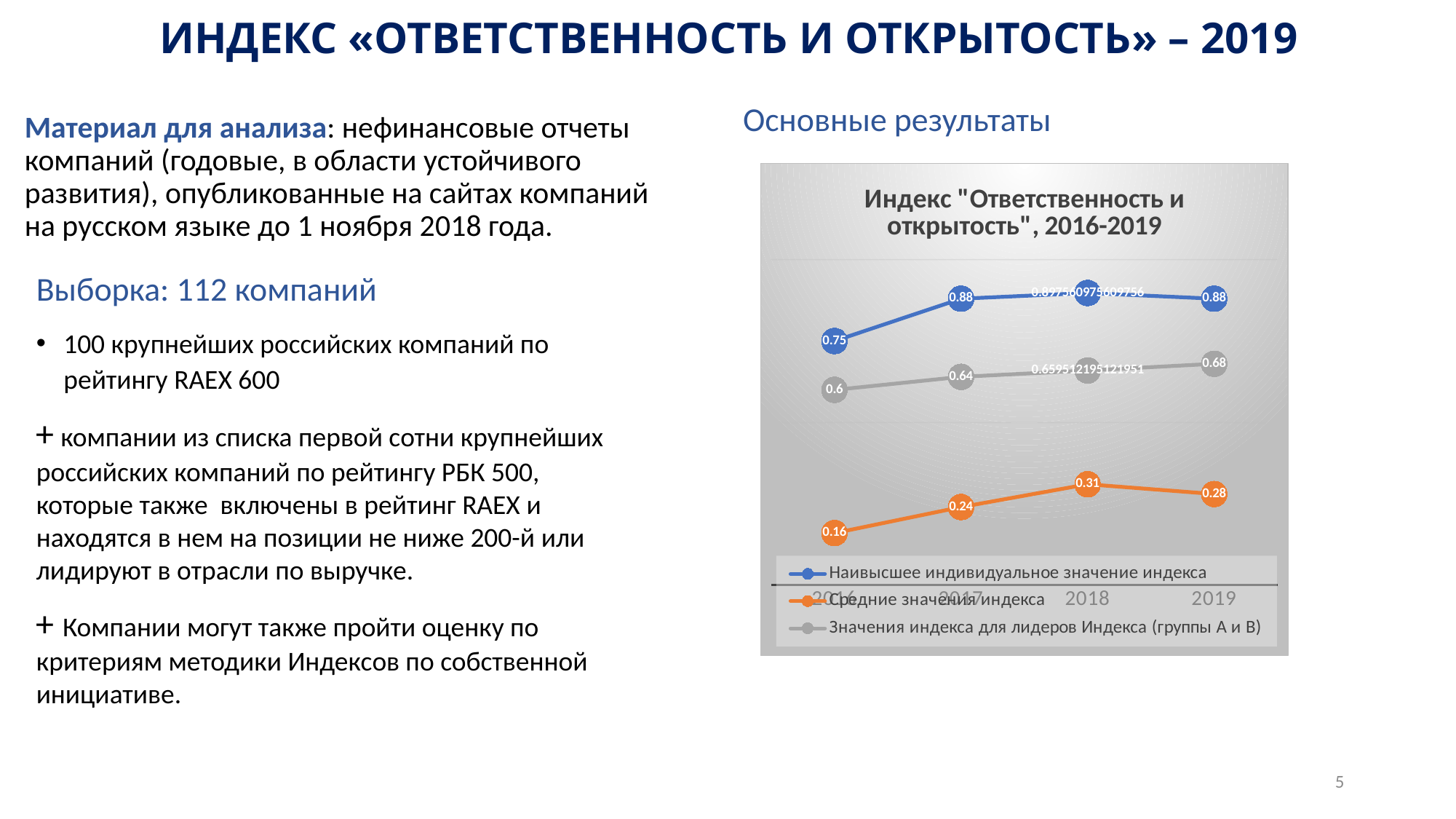
What is the difference between "Значения индекса для лидеров Индекса (группы А и В)" in 2019 and in 2016? 0.08 What is the value of "Средние значения индекса" in 2016? 0.16 What is the value of "Средние значения индекса" in 2018? 0.31 Which is larger in 2017: "Наивысшее индивидуальное значение индекса" or "Значения индекса для лидеров Индекса (группы А и В)"? Наивысшее индивидуальное значение индекса What kind of chart is shown on the slide? line chart What is the value of "Наивысшее индивидуальное значение индекса" in 2019? 0.88 In which year is "Средние значения индекса" highest? 2018 How many series does the chart legend list? 3 Does "Значения индекса для лидеров Индекса (группы А и В)" rise or fall from 2016 to 2019? rise What is the title of the chart? Индекс "Ответственность и открытость", 2016-2019 In which year is "Наивысшее индивидуальное значение индекса" lowest? 2016 What is the value of "Значения индекса для лидеров Индекса (группы А и В)" in 2017? 0.64